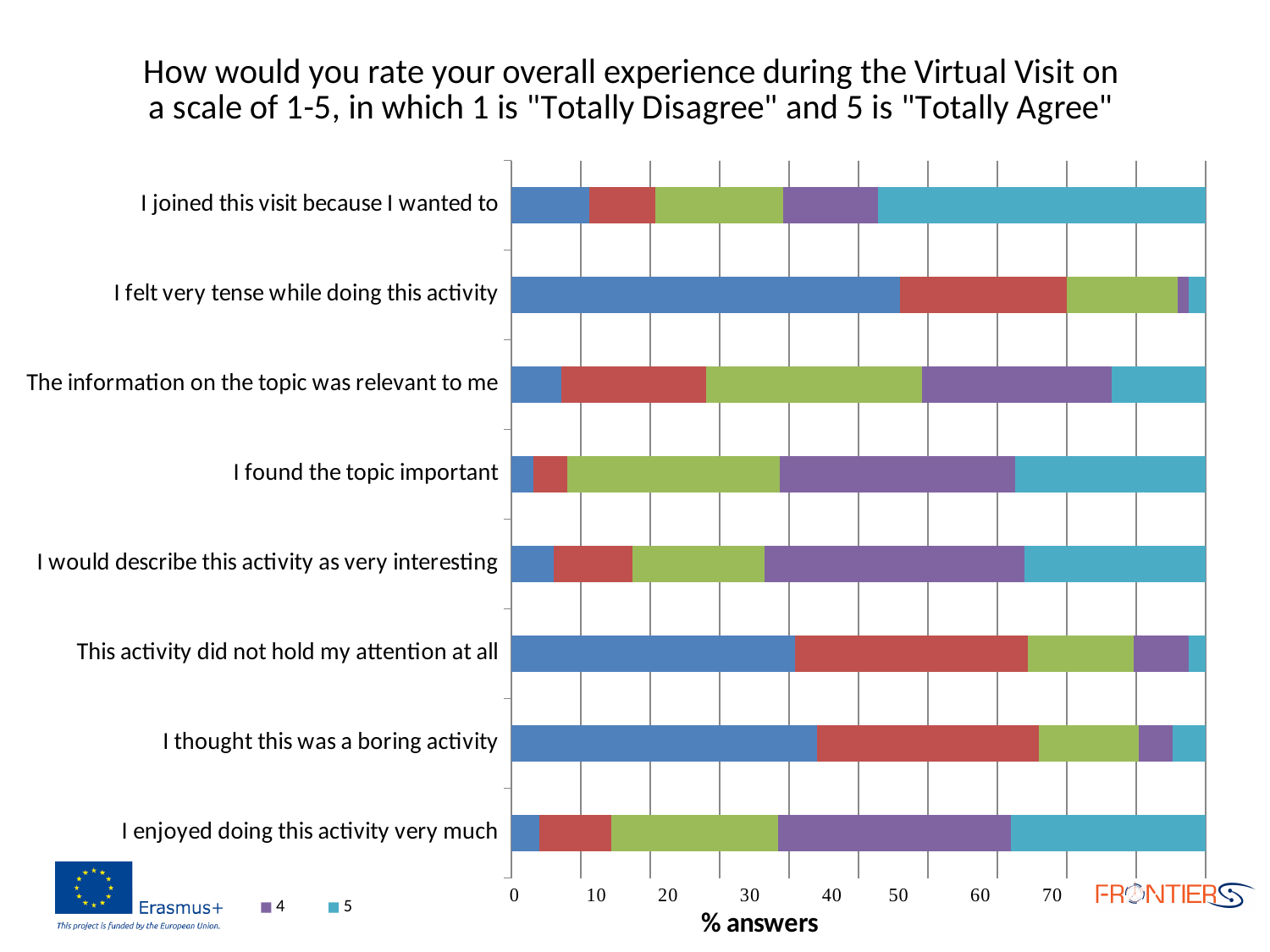
Is the '5' segment for 'I found the topic important' greater or less than 30? less Which has a larger '5' segment: 'I found the topic important' or 'I felt very tense while doing this activity'? I found the topic important Which statement has the largest '5' segment? I joined this visit because I wanted to How many statements (categories) are plotted on the chart? 8 Is the '5' segment for 'I thought this was a boring activity' greater or less than 10? less Which two rating values are visible in the chart legend? 4 and 5 What kind of chart is shown on the slide? Stacked bar chart Is the '4' segment for 'I felt very tense while doing this activity' greater or less than 10? less What is the label of the horizontal axis? % answers